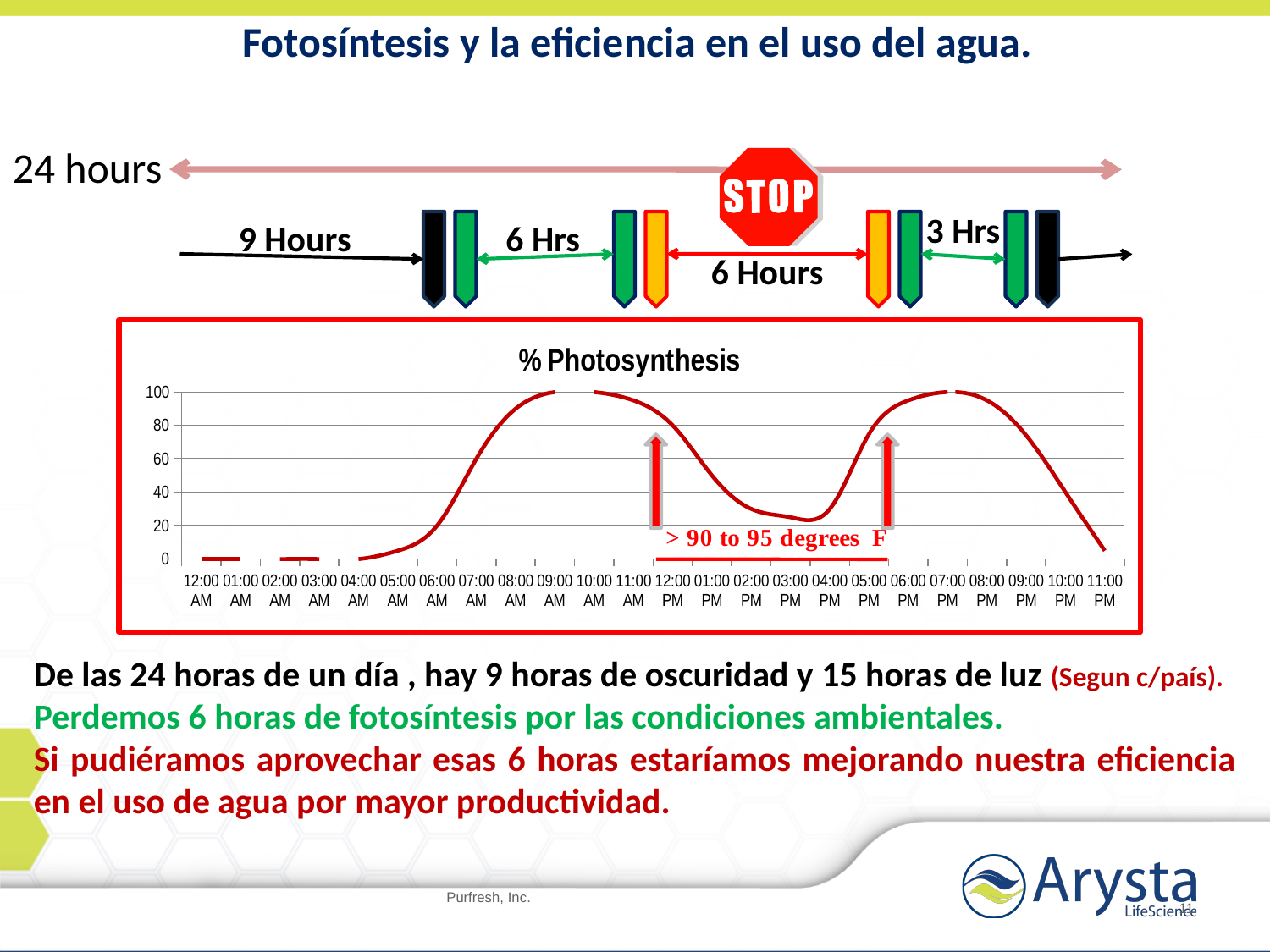
What temperature annotation is written in red on the chart? > 90 to 95 degrees F What is the title of the chart? % Photosynthesis Is the value of % Photosynthesis at 09:00 AM greater or less than 80? greater Is the value of % Photosynthesis at 08:00 AM greater or less than 60? greater Which has a higher % Photosynthesis value, 08:00 AM or 03:00 PM? 08:00 AM What is the value of % Photosynthesis at 12:00 AM? 0 Does % Photosynthesis rise or fall between 09:00 AM and 03:00 PM? fall Is the value of % Photosynthesis at 06:00 AM greater or less than 40? less Does % Photosynthesis rise or fall between 04:00 AM and 09:00 AM? rise What kind of chart is shown on the slide? line chart How many hourly time points are shown on the x axis of the chart? 24